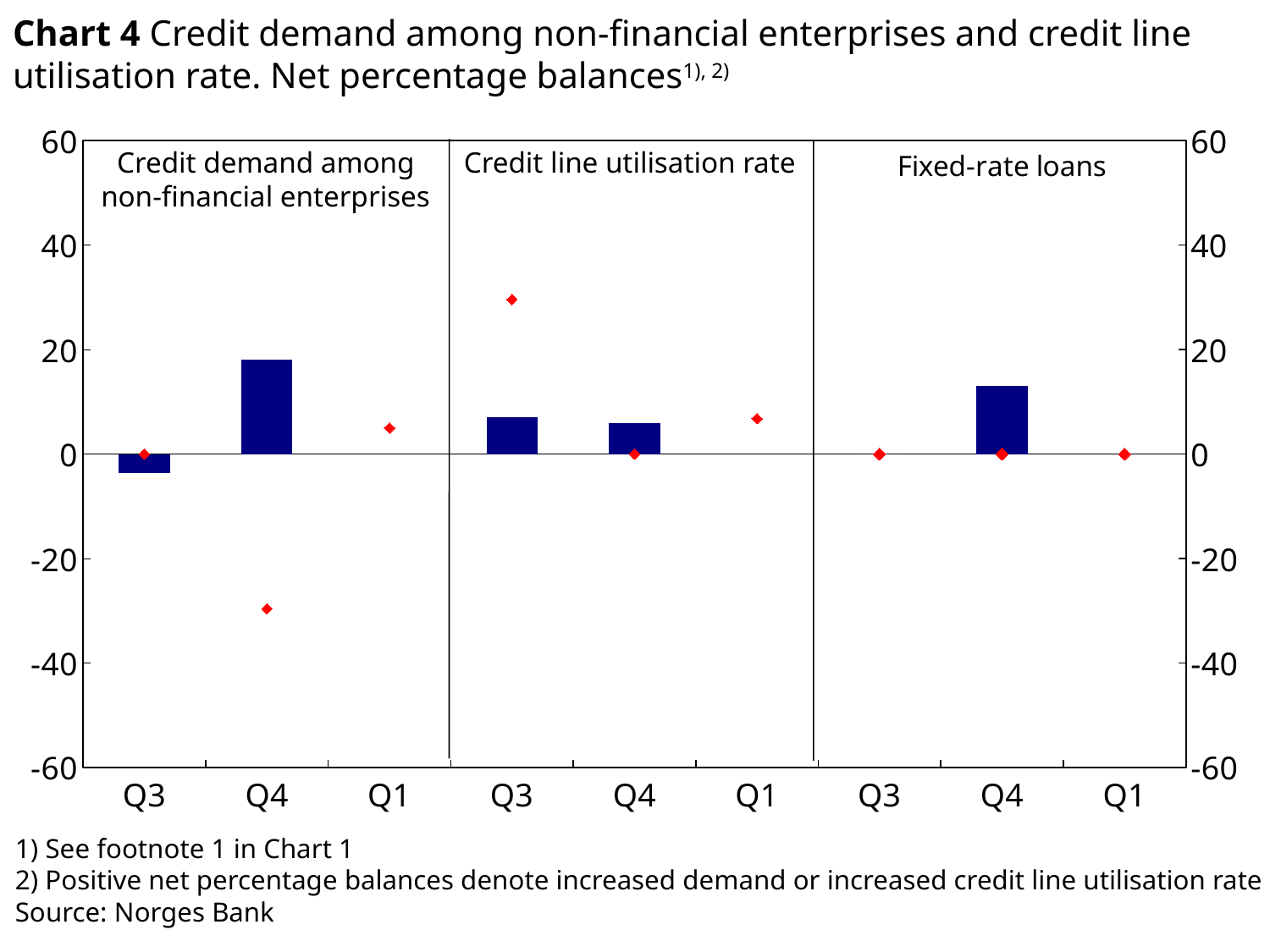
Which Q4 bar is taller: the one in the 'Credit demand among non-financial enterprises' panel or the one in the 'Fixed-rate loans' panel? Credit demand among non-financial enterprises In the 'Credit demand among non-financial enterprises' panel, is the red diamond for Q4 greater or less than -20? less How many panels (sections) does the chart have? 3 What kind of chart is shown on the slide? Combination bar and line chart (bars with red diamond markers) What is the source given for the chart? Norges Bank How many quarters are shown on the x axis of each panel? 3 In the 'Credit line utilisation rate' panel, is the red diamond for Q3 greater or less than 20? greater In the 'Credit demand among non-financial enterprises' panel, is the Q4 bar greater or less than 0? greater In the 'Credit demand among non-financial enterprises' panel, which quarter has the tallest bar? Q4 What is the title of the middle panel of the chart? Credit line utilisation rate In the 'Fixed-rate loans' panel, which quarter has a visible bar? Q4